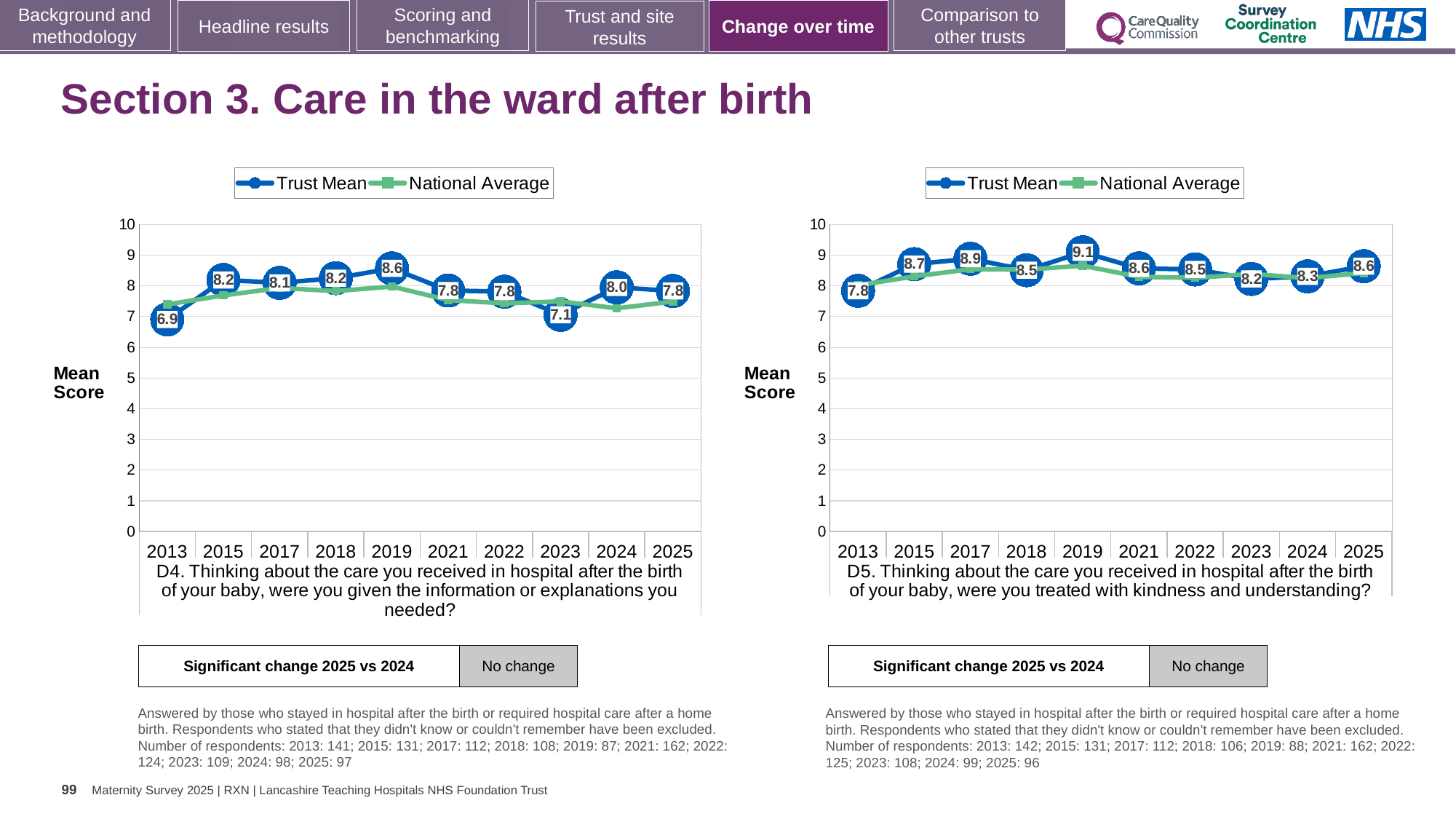
In the left chart (D4), which year has the highest Trust Mean score? 2019 In the right chart (D5), what is the difference between the Trust Mean scores for 2019 and 2013? 1.3 In the left chart (D4), what is the Trust Mean score for 2013? 6.9 What type of chart is the left chart (D4)? Line chart How many years are plotted on the x axis of the right chart (D5)? 10 In the right chart (D5), what is the Trust Mean score for 2019? 9.1 In the left chart (D4), what is the Trust Mean score for 2025? 7.8 In the right chart (D5), what is the Trust Mean score for 2023? 8.2 In the right chart (D5), which year has the lowest Trust Mean score? 2013 In the left chart (D4), is the Trust Mean score higher in 2024 or in 2023? 2024 In the left chart (D4), is the National Average for 2013 greater or less than 7? greater In the left chart (D4), which year has the lowest Trust Mean score? 2013